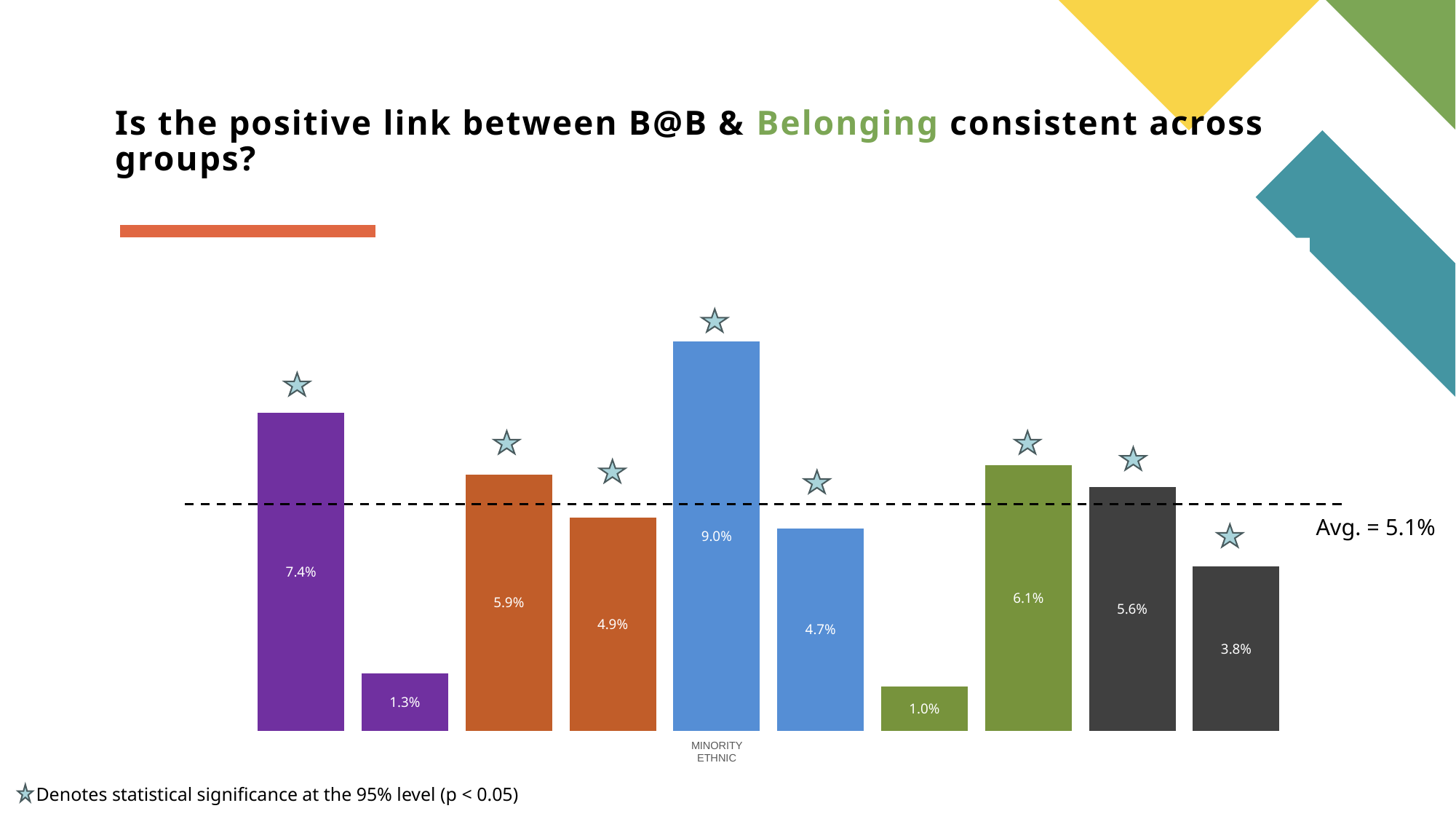
What average value is marked by the dashed line on the chart? 5.1% How many bars are plotted in the chart? 10 Is the value for Minority Ethnic greater or less than the 5.1% average line? greater Which labelled group has the highest bar in the chart? Minority Ethnic What is the value shown for the Minority Ethnic bar? 9.0% According to the footnote, what does the star symbol above a bar denote? Statistical significance at the 95% level (p < 0.05) What is the value of the lowest bar in the chart? 1.0% What kind of chart is shown on the slide? Bar chart What is the value of the highest bar in the chart? 9.0% Which is larger: the Minority Ethnic bar or the leftmost bar (7.4%)? Minority Ethnic How many bars in the chart are marked with a star? 8 By how much does the Minority Ethnic value exceed the 5.1% average? 3.9%